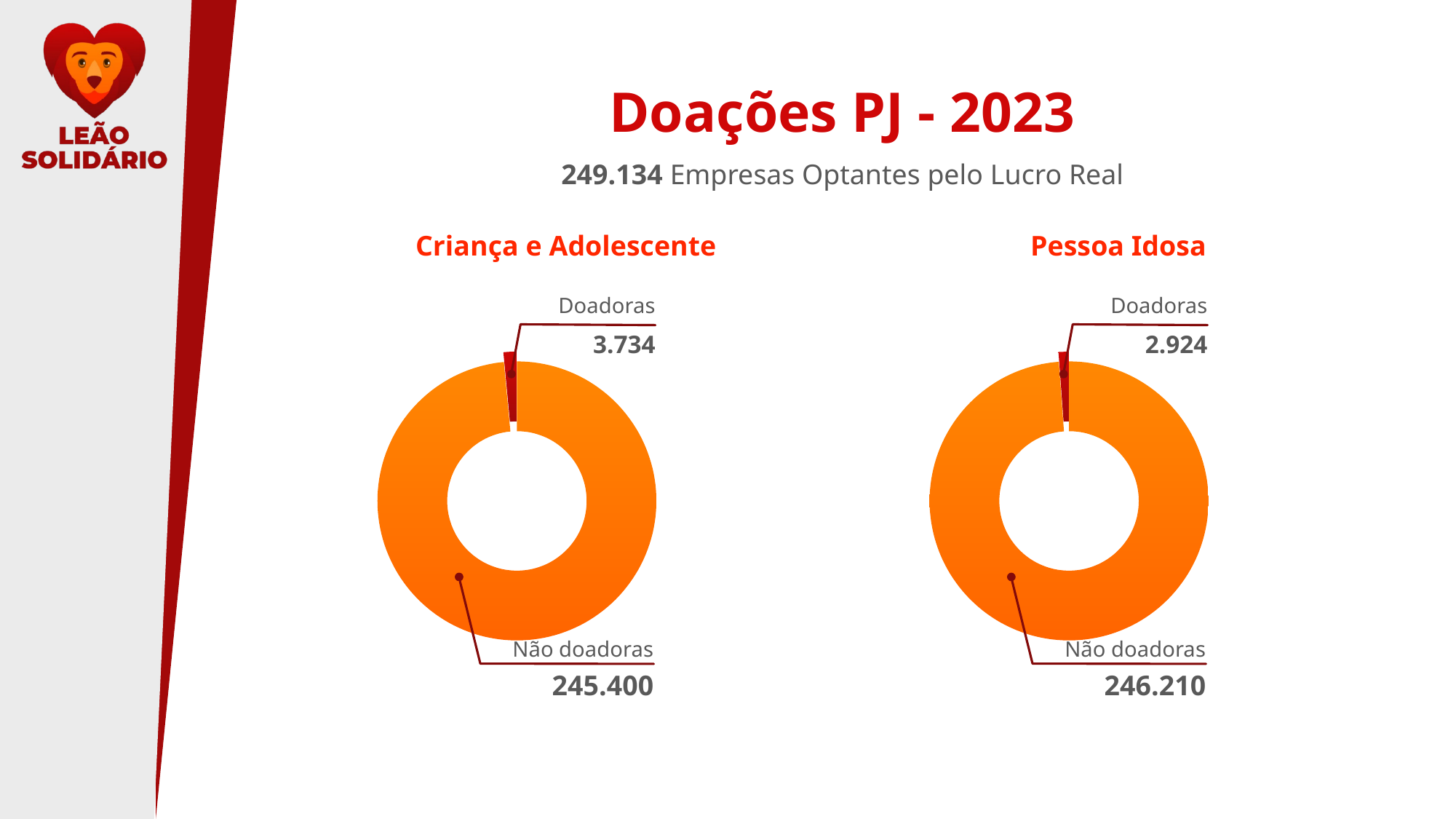
In the Pessoa Idosa chart, what is the value for Não doadoras? 246.210 In the Pessoa Idosa chart, which category has the smallest value? Doadoras What is the total of the two categories in the Pessoa Idosa chart? 249.134 In the Criança e Adolescente chart, what is the value for Doadoras? 3.734 In the Criança e Adolescente chart, what is the value for Não doadoras? 245.400 In the Criança e Adolescente chart, which category has the largest value? Não doadoras Which is larger: Doadoras in the Criança e Adolescente chart or Doadoras in the Pessoa Idosa chart? Criança e Adolescente What kind of chart is the Pessoa Idosa chart? Doughnut chart In the Criança e Adolescente chart, what is the difference between Não doadoras and Doadoras? 241.666 In the Pessoa Idosa chart, what is the value for Doadoras? 2.924 How many categories does the Criança e Adolescente chart show? 2 In the Pessoa Idosa chart, what is the difference between Não doadoras and Doadoras? 243.286